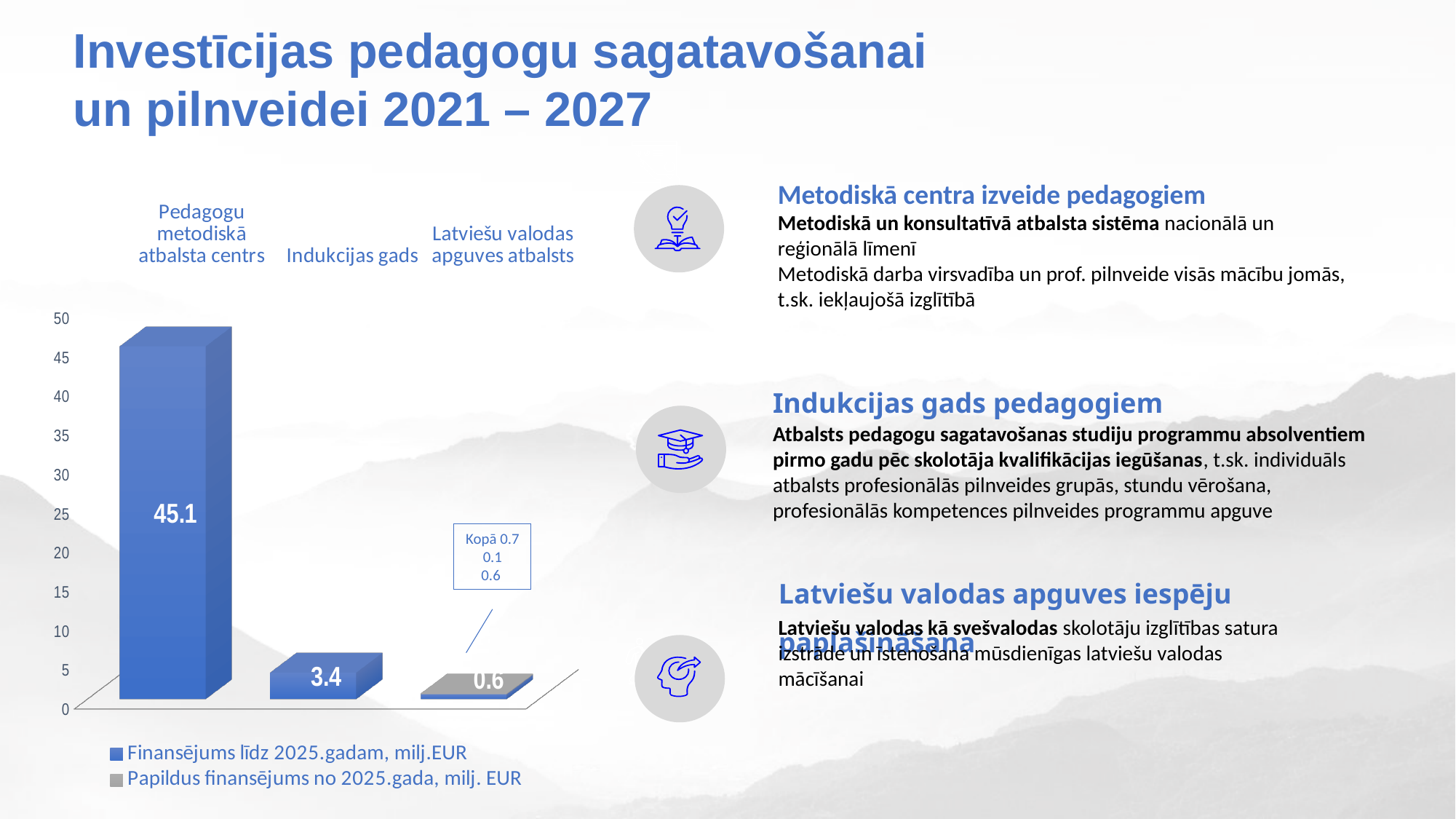
What is the value of 'Finansējums līdz 2025.gadam, milj.EUR' for 'Indukcijas gads'? 3.4 What is the value of 'Papildus finansējums no 2025.gada, milj. EUR' for 'Latviešu valodas apguves atbalsts'? 0.1 What is the total of the stacked bar for 'Latviešu valodas apguves atbalsts'? 0.7 Which category has the lowest total value? Latviešu valodas apguves atbalsts How many series does the legend list? 2 What is the difference between the 'Finansējums līdz 2025.gadam' values for 'Pedagogu metodiskā atbalsta centrs' and 'Indukcijas gads'? 41.7 What kind of chart is shown on the slide? Bar chart What is the value of 'Finansējums līdz 2025.gadam, milj.EUR' for 'Pedagogu metodiskā atbalsta centrs'? 45.1 Which is larger: the value for 'Indukcijas gads' or the total for 'Latviešu valodas apguves atbalsts'? Indukcijas gads How many categories are shown on the chart? 3 Which category has the highest value? Pedagogu metodiskā atbalsta centrs What is the value of 'Finansējums līdz 2025.gadam, milj.EUR' for 'Latviešu valodas apguves atbalsts'? 0.6